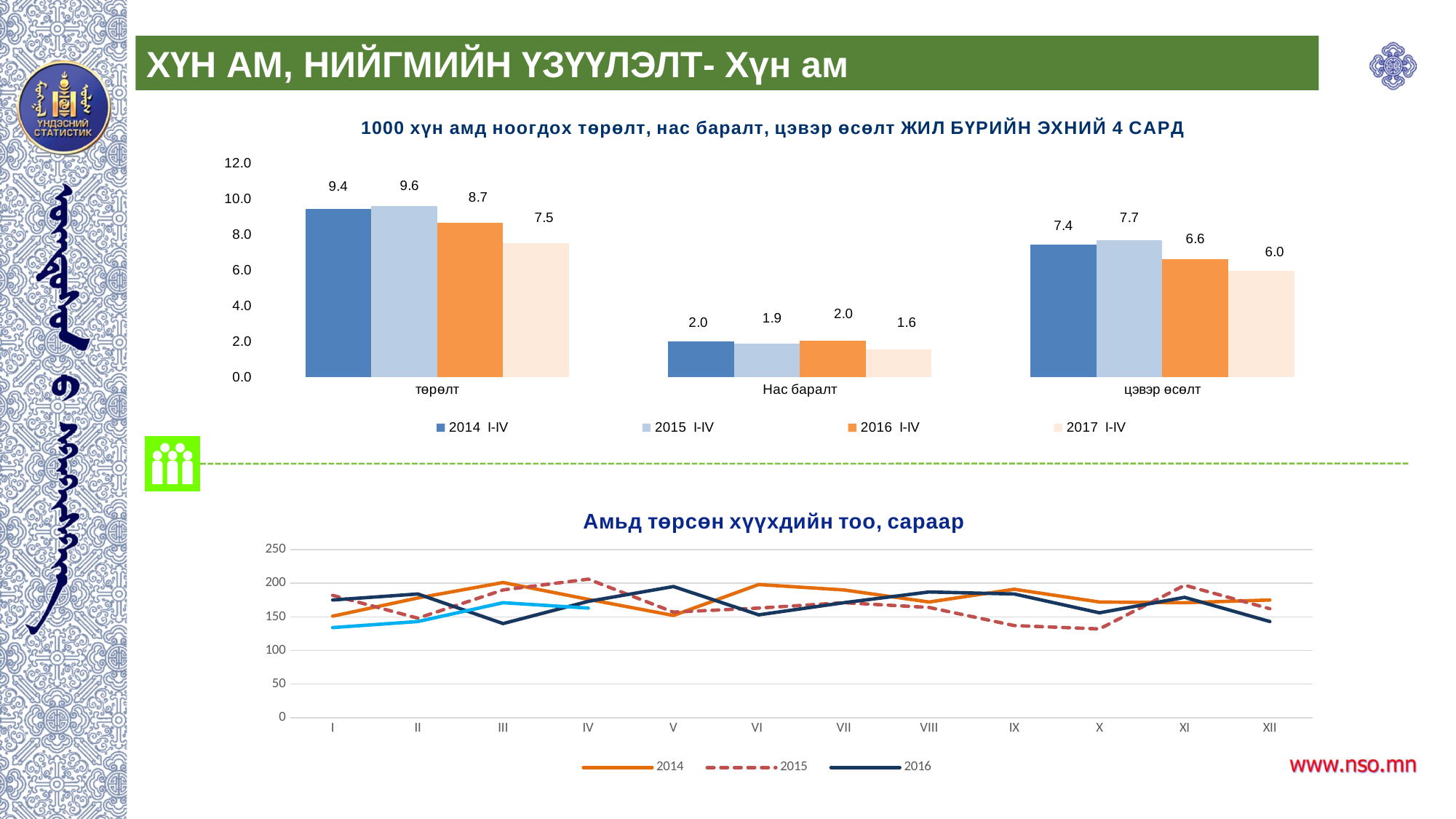
What kind of chart is the top chart on the slide? bar chart How many series does the legend of the top chart list? 4 In the top chart, what is the value for 2017 I-IV in the цэвэр өсөлт category? 6.0 What kind of chart is the bottom chart titled 'Амьд төрсөн хүүхдийн тоо, сараар'? line chart In the bottom chart, is the value for 2015 in month X greater or less than 150? less In the bottom chart, how many months are shown on the x axis? 12 In the top chart, what is the value for 2016 I-IV in the Нас баралт category? 2.0 In the top chart, what is the difference between the 2014 I-IV and 2017 I-IV values in the төрөлт category? 1.9 In the top chart, which series has the highest value in the төрөлт category? 2015 I-IV In the top chart, which is larger in the цэвэр өсөлт category: 2016 I-IV or 2017 I-IV? 2016 I-IV In the top chart, which series has the lowest value in the Нас баралт category? 2017 I-IV In the top chart, what is the value for 2015 I-IV in the төрөлт category? 9.6